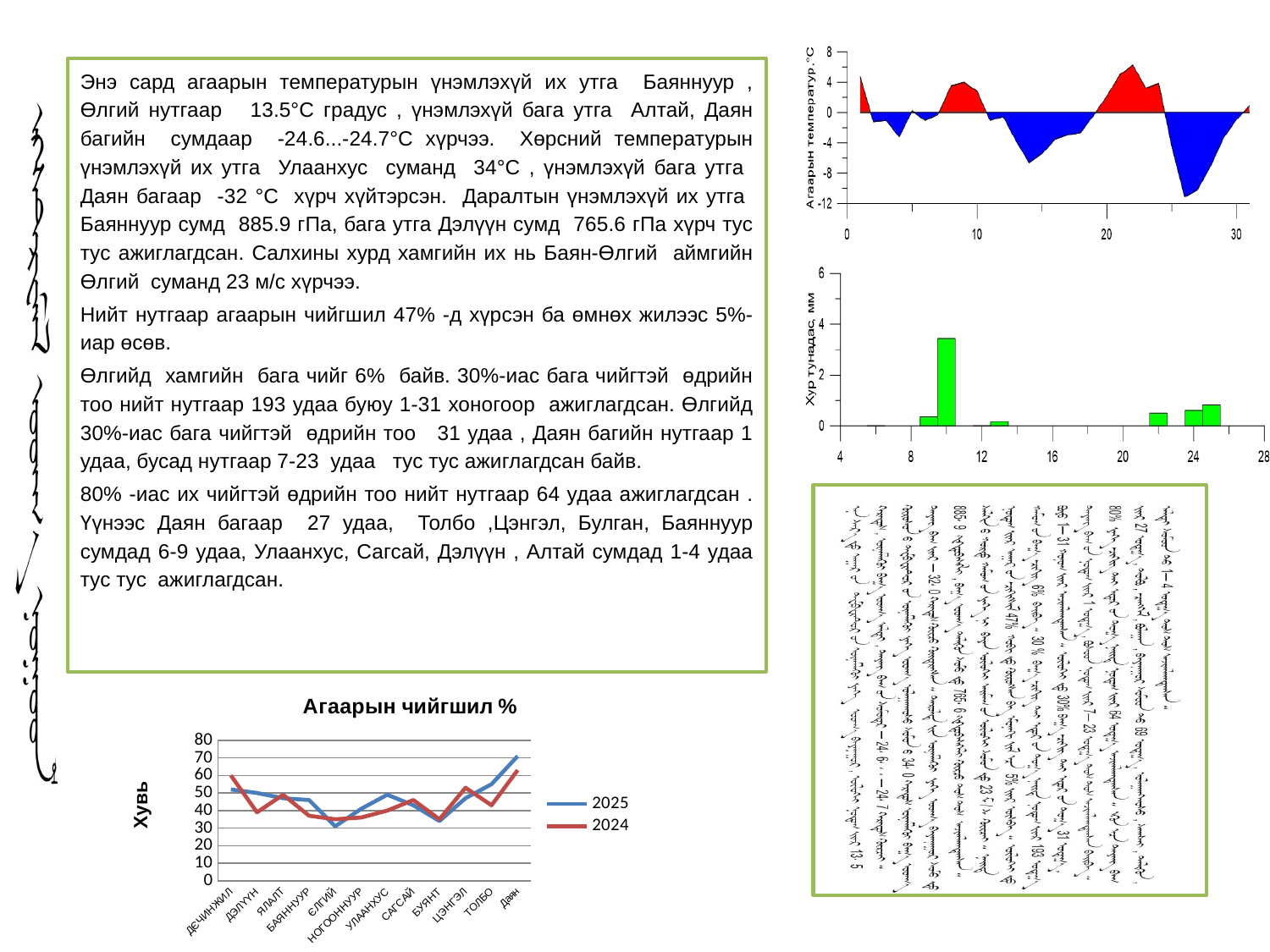
What kind of chart is the 'Агаарын чийгшил %' chart at the bottom left of the slide? line chart In the 'Агаарын температур, °C' chart at the top right, is the lowest temperature value greater or less than -8? less In the 'Агаарын чийгшил %' chart, which category has the highest value for the 2025 series? Даян In the 'Агаарын чийгшил %' chart, which series has the larger value for ДЭЧИНЖИЛ, 2025 or 2024? 2024 In the 'Агаарын температур, °C' chart at the top right, what colour is used for the area below 0? blue In the 'Агаарын чийгшил %' chart, is the 2025 value for ӨЛГИЙ greater or less than 40? less In the 'Агаарын чийгшил %' chart, which series has the larger value for ТОЛБО, 2025 or 2024? 2025 How many series does the legend of the 'Агаарын чийгшил %' chart list? 2 What kind of chart is the 'Хур тунадас, мм' chart on the right side of the slide? bar chart How many categories are shown on the x axis of the 'Агаарын чийгшил %' chart? 12 In the 'Хур тунадас, мм' chart, is the tallest bar greater or less than 2 mm? greater